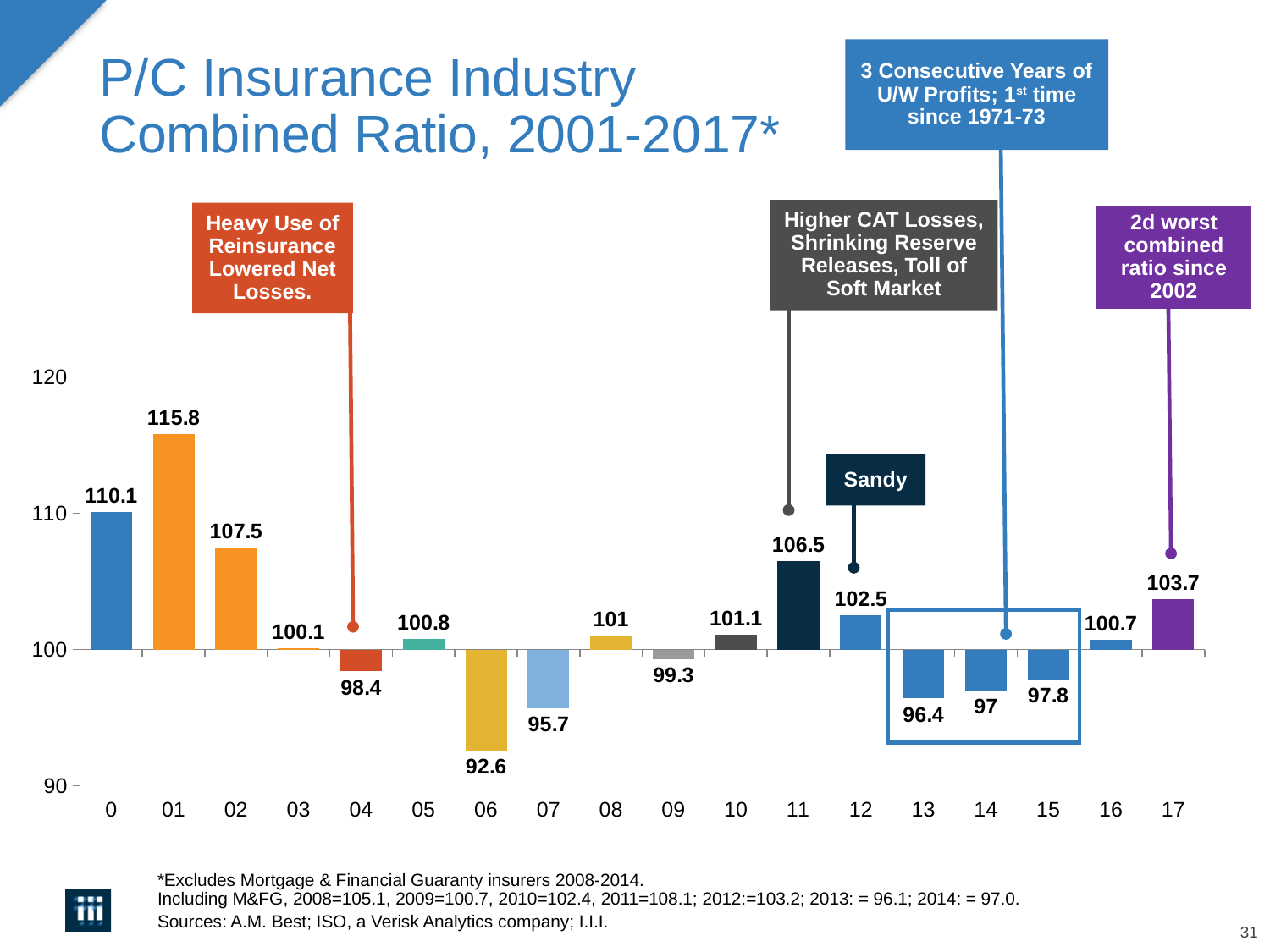
Which year is labelled with the 'Sandy' callout on the chart? 12 What is the combined ratio shown for 17? 103.7 What is the combined ratio shown for 06? 92.6 Which year has the highest combined ratio on the chart? 01 What kind of chart is shown on the slide? Bar chart Do the combined ratio values rise or fall from 13 to 15? Rise What is the difference between the combined ratio for 01 and the combined ratio for 02? 8.3 How many bars are plotted on the chart? 18 Which has the larger combined ratio, 12 or 16? 12 Which year has the lowest combined ratio on the chart? 06 What is the combined ratio shown for 11? 106.5 What is the combined ratio shown for 01? 115.8